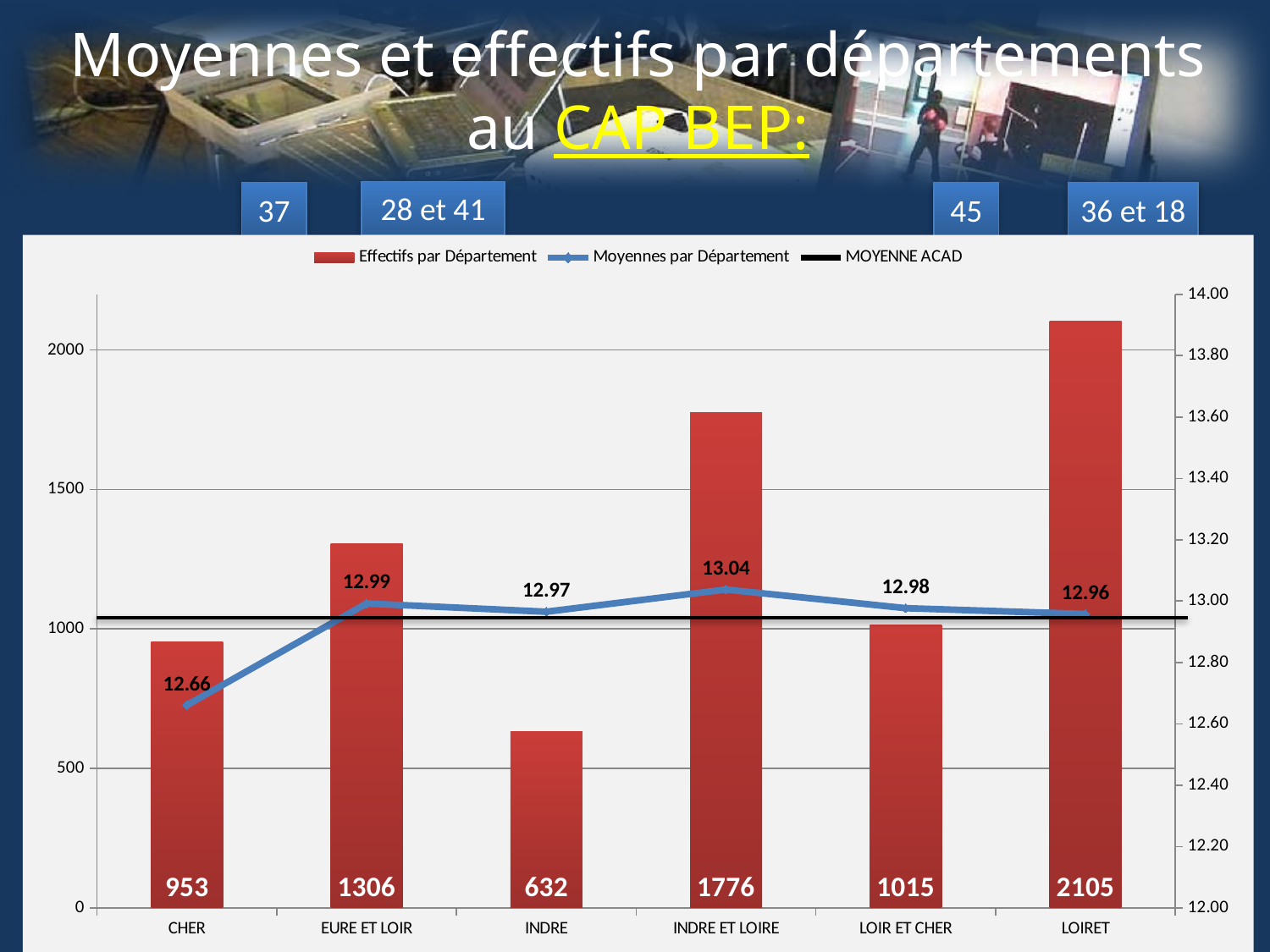
What is the difference in Moyennes par Département between INDRE ET LOIRE and CHER? 0.38 Which department has the highest Moyennes par Département? INDRE ET LOIRE Which department has the lowest Effectifs par Département? INDRE What is the difference in Effectifs par Département between LOIRET and INDRE? 1473 What is the value of Effectifs par Département for LOIRET? 2105 Which is larger, the Effectifs par Département for EURE ET LOIR or for LOIR ET CHER? EURE ET LOIR What is the value of Effectifs par Département for INDRE ET LOIRE? 1776 How many series does the legend list? 3 Which department has the lowest Moyennes par Département? CHER How many departments are shown on the x axis? 6 What is the value of Moyennes par Département for CHER? 12.66 Which department has the highest Effectifs par Département? LOIRET